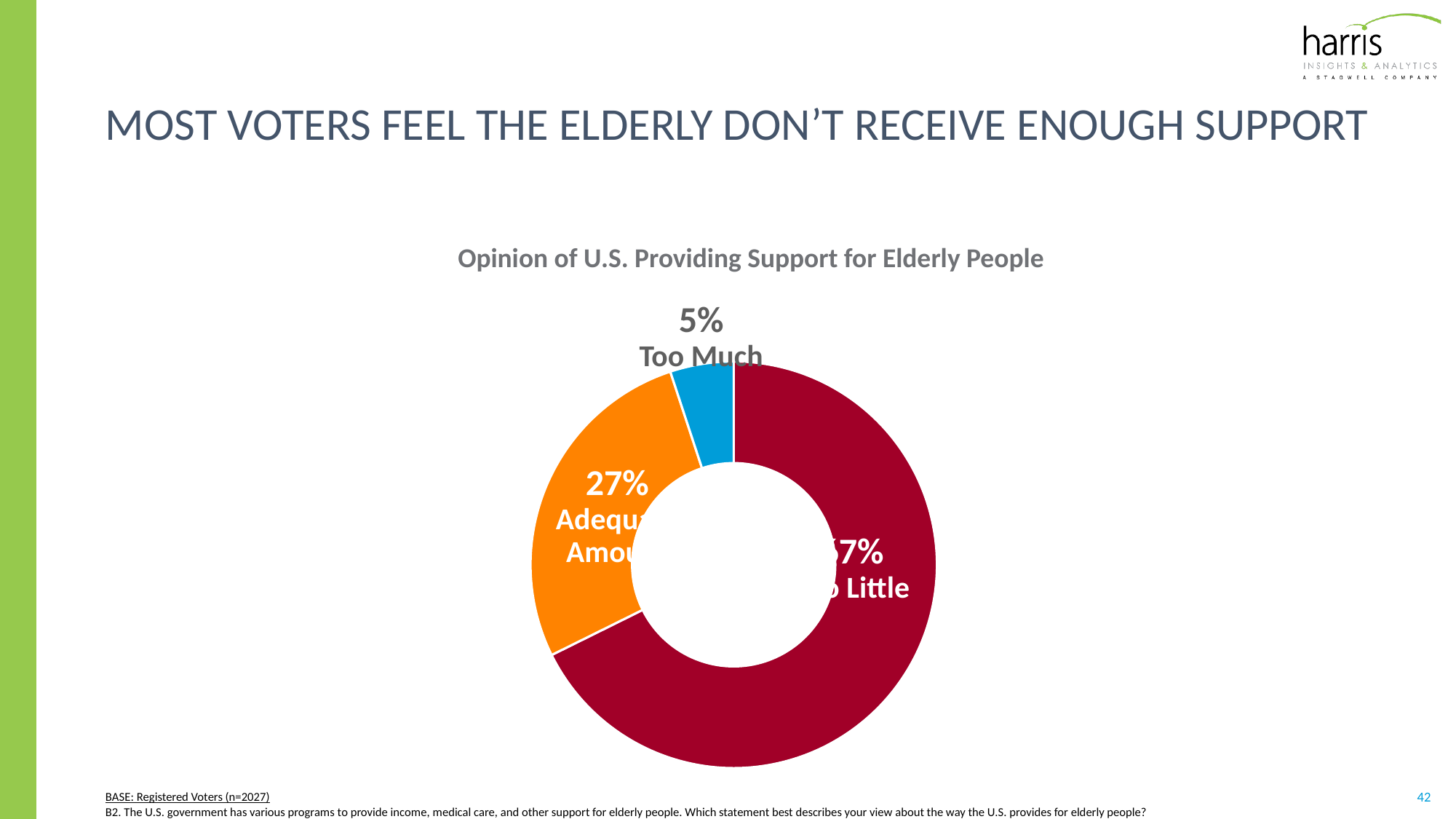
How many percentage points higher is Adequate Amount than Too Much? 22 percentage points What percentage of voters say the U.S. provides an Adequate Amount of support for elderly people? 27% What percentage of voters say the U.S. provides Too Much support for elderly people? 5% Which is larger, the Adequate Amount slice or the Too Much slice? Adequate Amount Which response has the smallest slice of the chart? Too Much What colour is the Too Much slice? Blue What kind of chart is shown on the slide? pie chart (donut) Which response has the largest slice of the chart? Too Little What share of the pie does the Too Much slice represent? 5% How many response categories are shown in the chart? 3 Which is larger, the Too Little slice or the Adequate Amount slice? Too Little What is the title of the chart? Opinion of U.S. Providing Support for Elderly People